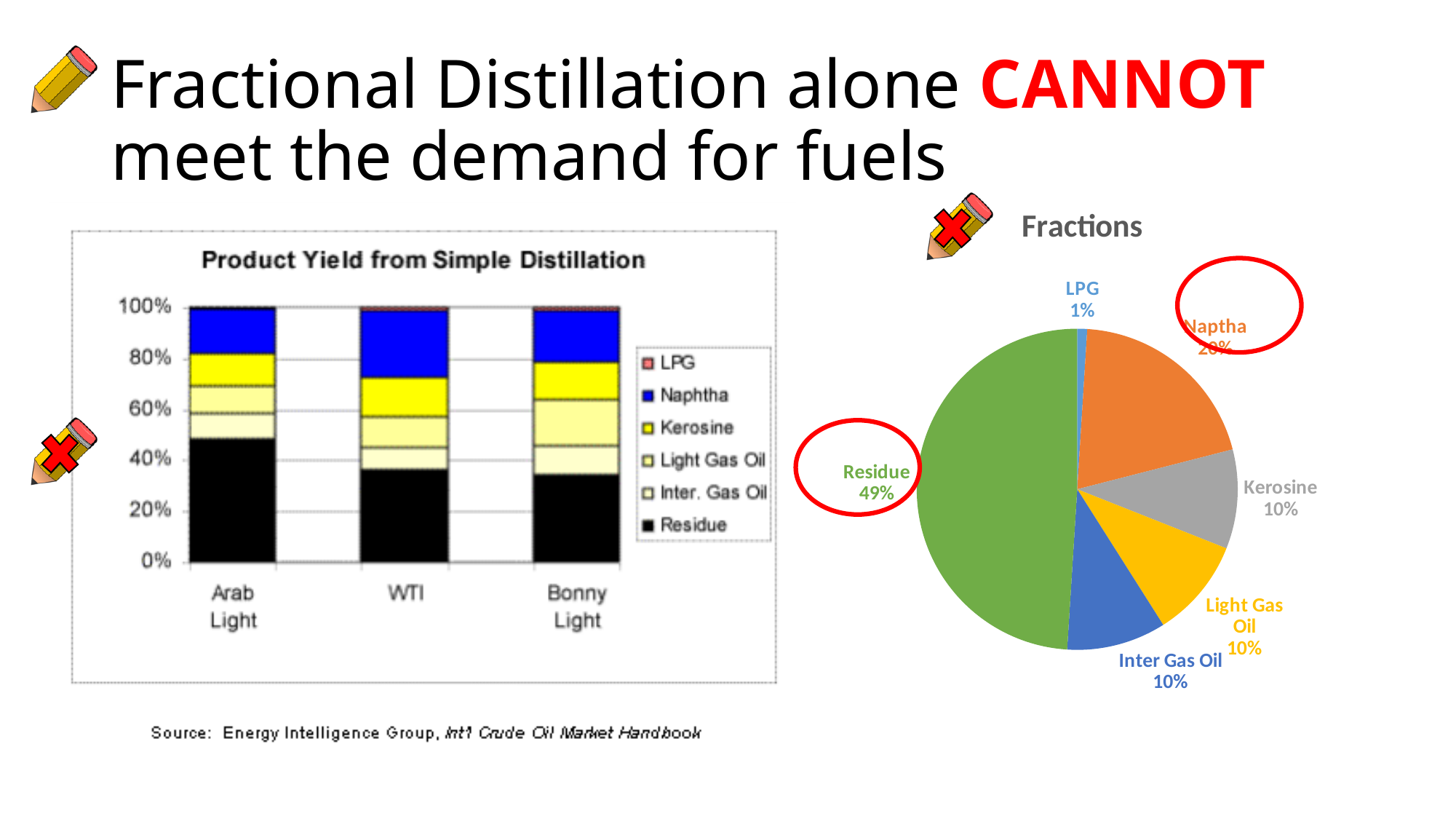
In the 'Fractions' pie chart, what is the difference between the Residue share and the LPG share? 48% How many series does the legend of the 'Product Yield from Simple Distillation' chart list? 6 What type of chart is the 'Product Yield from Simple Distillation' chart on the left? Stacked bar chart How many slices does the 'Fractions' pie chart have? 6 How many crude oil types are shown on the x axis of the 'Product Yield from Simple Distillation' chart? 3 In the 'Product Yield from Simple Distillation' chart, which crude oil has the largest Naphtha share? WTI In the 'Product Yield from Simple Distillation' chart, is the Residue share for Arab Light greater or less than 40%? greater In the 'Product Yield from Simple Distillation' chart, which crude oil has the largest Residue share? Arab Light In the 'Fractions' pie chart, which fraction has the smallest share? LPG In the 'Product Yield from Simple Distillation' chart, is the Residue share for WTI greater or less than 40%? less What type of chart is the 'Fractions' chart on the right? Pie chart In the 'Fractions' pie chart, what share does Residue have? 49%